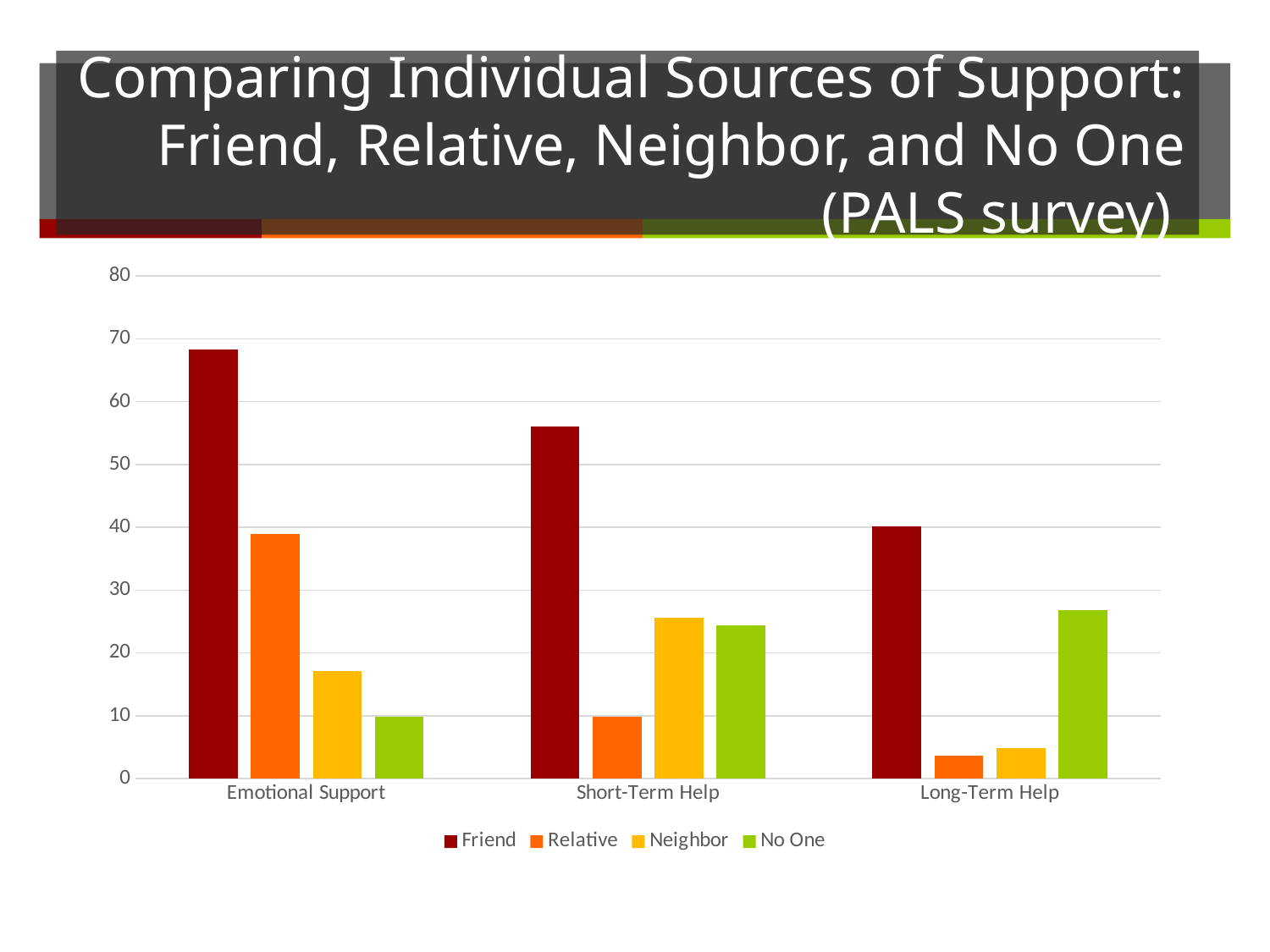
In the Long-Term Help category, which is larger: Friend or No One? Friend Is the Friend value for Short-Term Help greater or less than 50? greater Which series has the lowest value in the Emotional Support category? No One How many categories are shown on the x axis? 3 Do the No One values rise or fall from Emotional Support to Long-Term Help? rise Do the Friend values rise or fall from Emotional Support to Long-Term Help? fall Is the Friend value for Emotional Support greater or less than 60? greater In which category is the Friend value highest? Emotional Support How many series does the legend list? 4 In the Emotional Support category, which is larger: Relative or Neighbor? Relative What kind of chart is shown on the slide? Bar chart Is the No One value for Long-Term Help greater or less than 20? greater